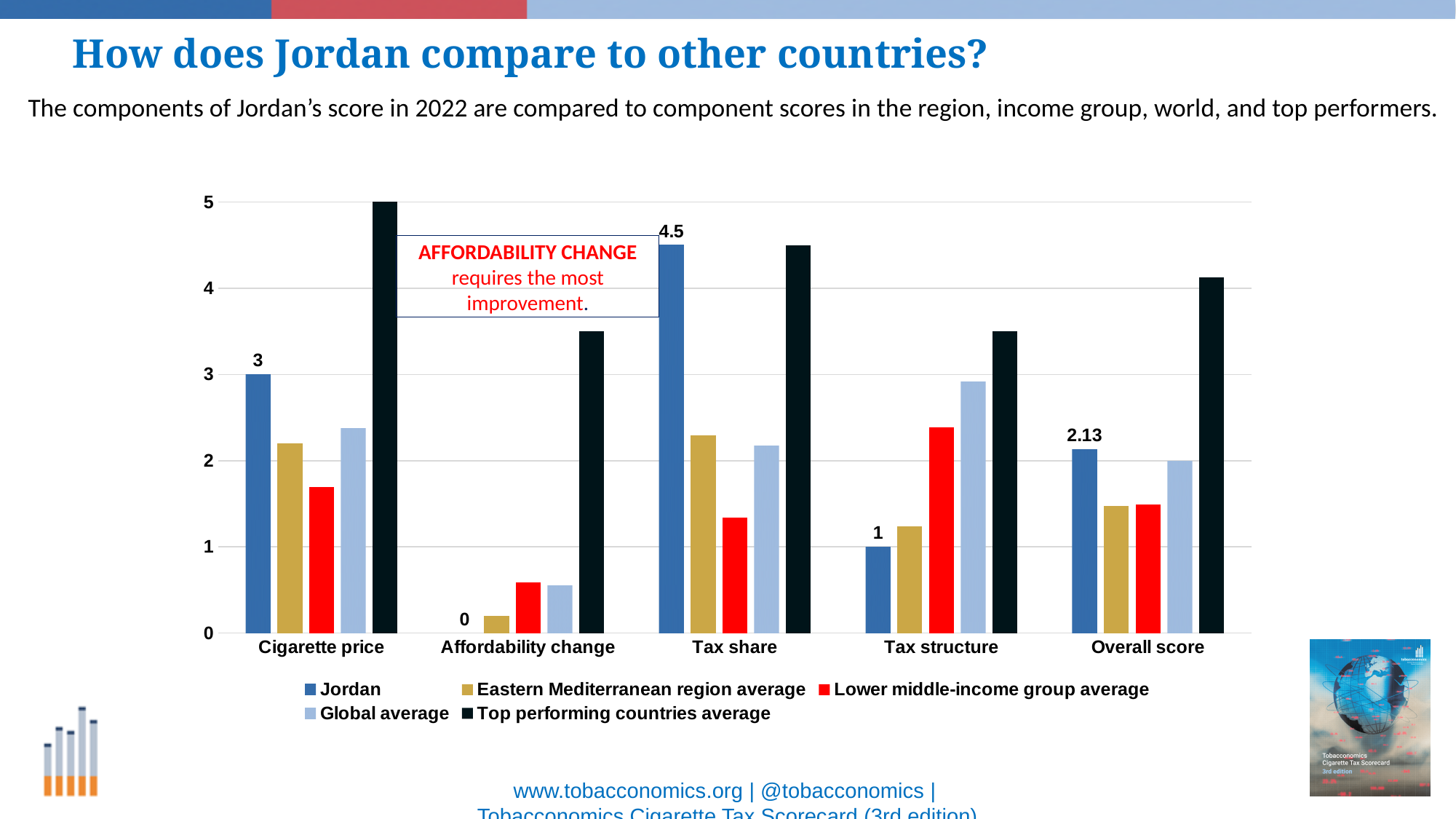
What is Jordan's value for Affordability change? 0 Which component has Jordan's highest score? Tax share What is Jordan's Overall score? 2.13 What is Jordan's value for Cigarette price? 3 What is Jordan's value for Tax share? 4.5 How many categories are shown on the x axis? 5 Which component has Jordan's lowest score? Affordability change What is the Top performing countries average for Cigarette price? 5 How many series does the legend list? 5 What is the difference between Jordan's Tax share and Cigarette price scores? 1.5 What kind of chart is shown on the slide? bar chart Is the Global average for Tax structure greater or less than 2? greater